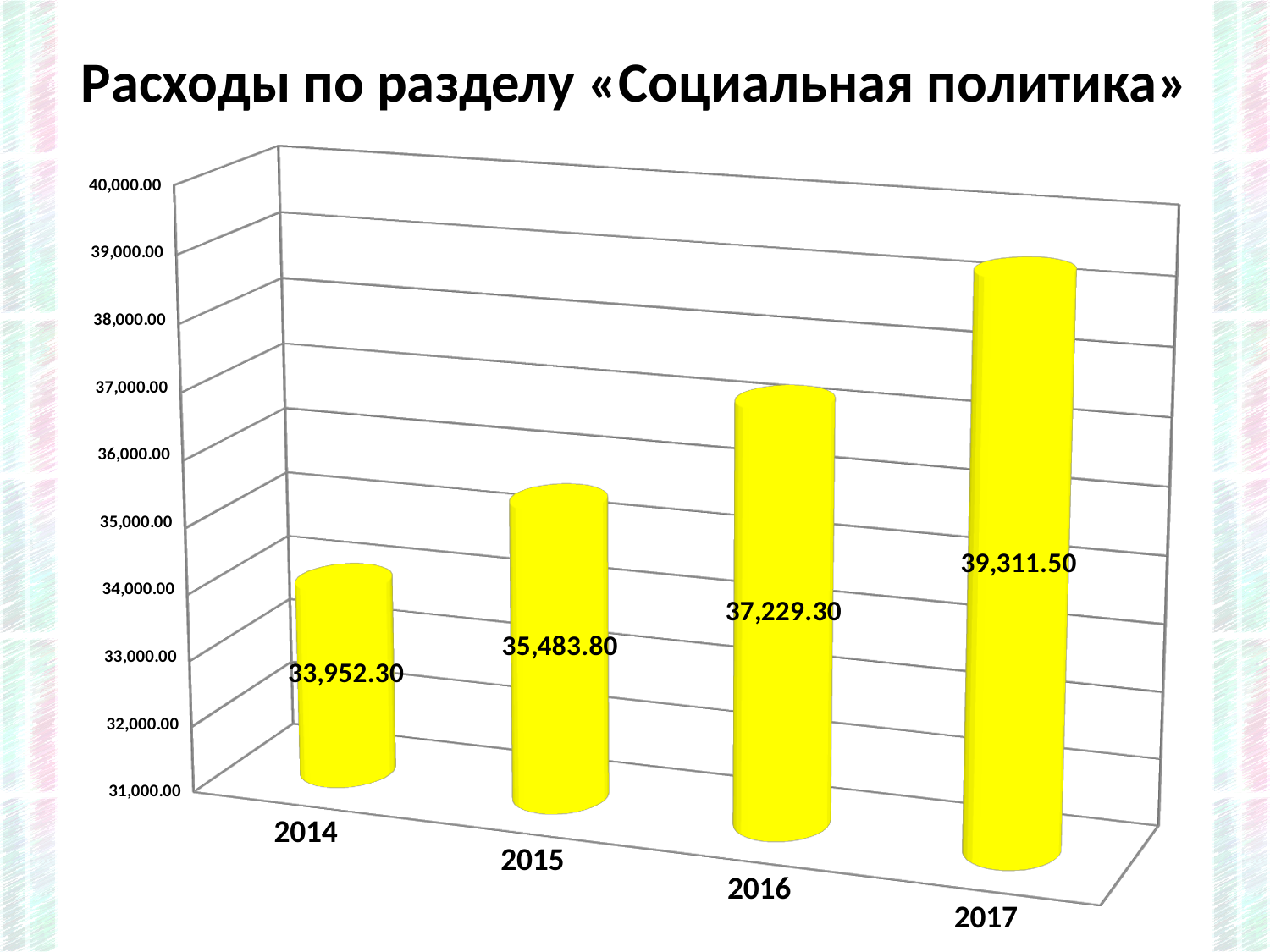
Which is larger, the value for 2015 or the value for 2016? 2016 Which year has the highest value? 2017 What is the value for 2014? 33,952.30 What is the difference between the values for 2017 and 2014? 5,359.20 What is the value for 2016? 37,229.30 Which year has the lowest value? 2014 Do the values rise or fall from 2014 to 2017? rise What is the difference between the values for 2016 and 2015? 1,745.50 What is the value for 2015? 35,483.80 Is the value for 2017 greater or less than 38,000.00? greater How many years are shown on the x axis? 4 What is the value for 2017? 39,311.50